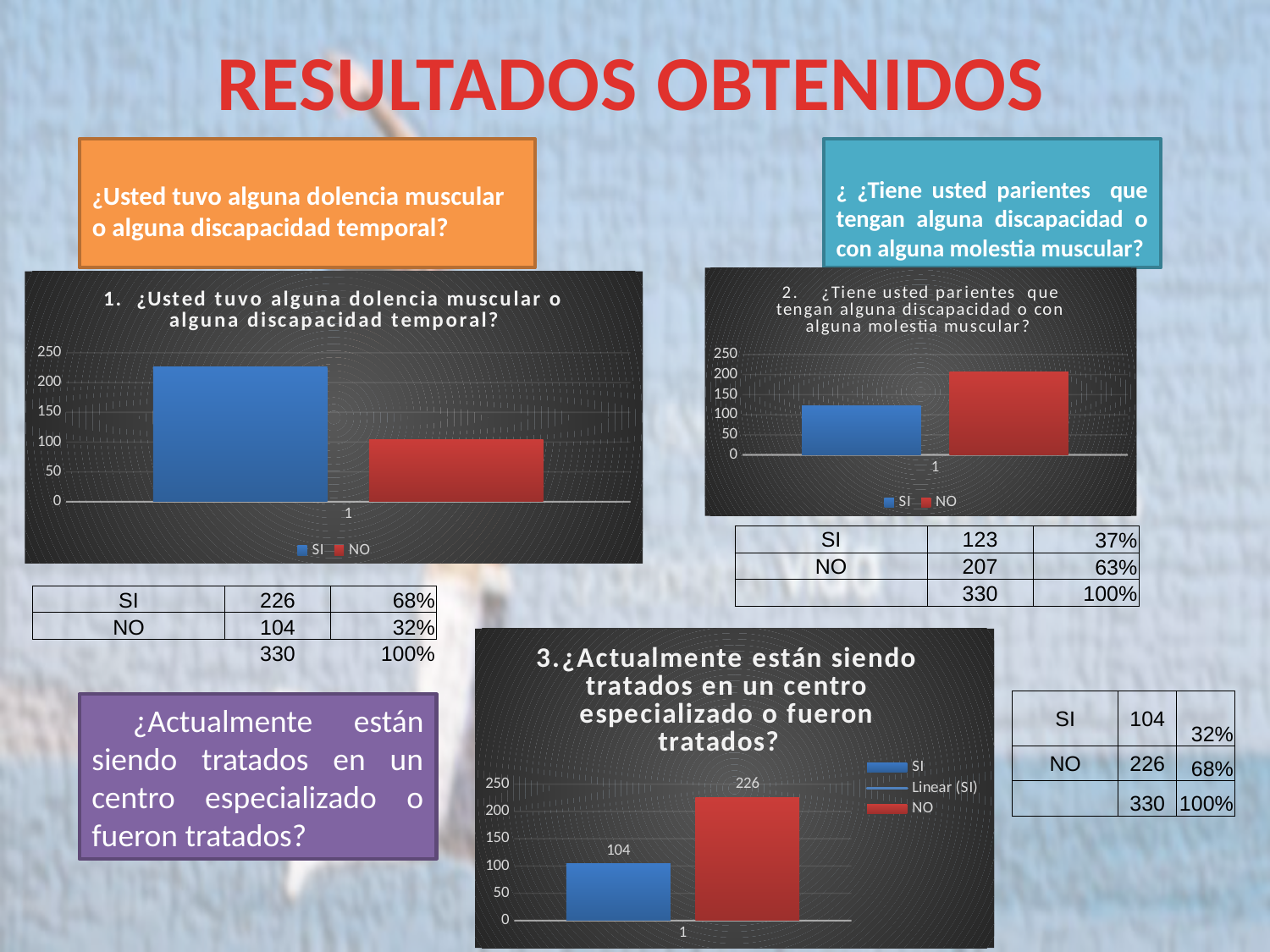
What type of chart is the chart titled "1. ¿Usted tuvo alguna dolencia muscular o alguna discapacidad temporal?"? Bar chart In the chart titled "3.¿Actualmente están siendo tratados en un centro especializado o fueron tratados?", what is the difference between the NO value and the SI value? 122 How many entries does the legend list in the chart titled "3.¿Actualmente están siendo tratados en un centro especializado o fueron tratados?"? 3 In the chart titled "1. ¿Usted tuvo alguna dolencia muscular o alguna discapacidad temporal?", is the value for NO greater or less than 150? less In the chart titled "2. ¿Tiene usted parientes que tengan alguna discapacidad o con alguna molestia muscular?", which series has the highest value? NO In the chart titled "1. ¿Usted tuvo alguna dolencia muscular o alguna discapacidad temporal?", which bar is taller, SI or NO? SI In the chart titled "3.¿Actualmente están siendo tratados en un centro especializado o fueron tratados?", what is the value for SI? 104 In the chart titled "2. ¿Tiene usted parientes que tengan alguna discapacidad o con alguna molestia muscular?", is the value for NO greater or less than 150? greater In the chart titled "3.¿Actualmente están siendo tratados en un centro especializado o fueron tratados?", what is the value for NO? 226 In the chart titled "2. ¿Tiene usted parientes que tengan alguna discapacidad o con alguna molestia muscular?", is the value for SI greater or less than 150? less In the chart titled "3.¿Actualmente están siendo tratados en un centro especializado o fueron tratados?", which is larger, SI or NO? NO